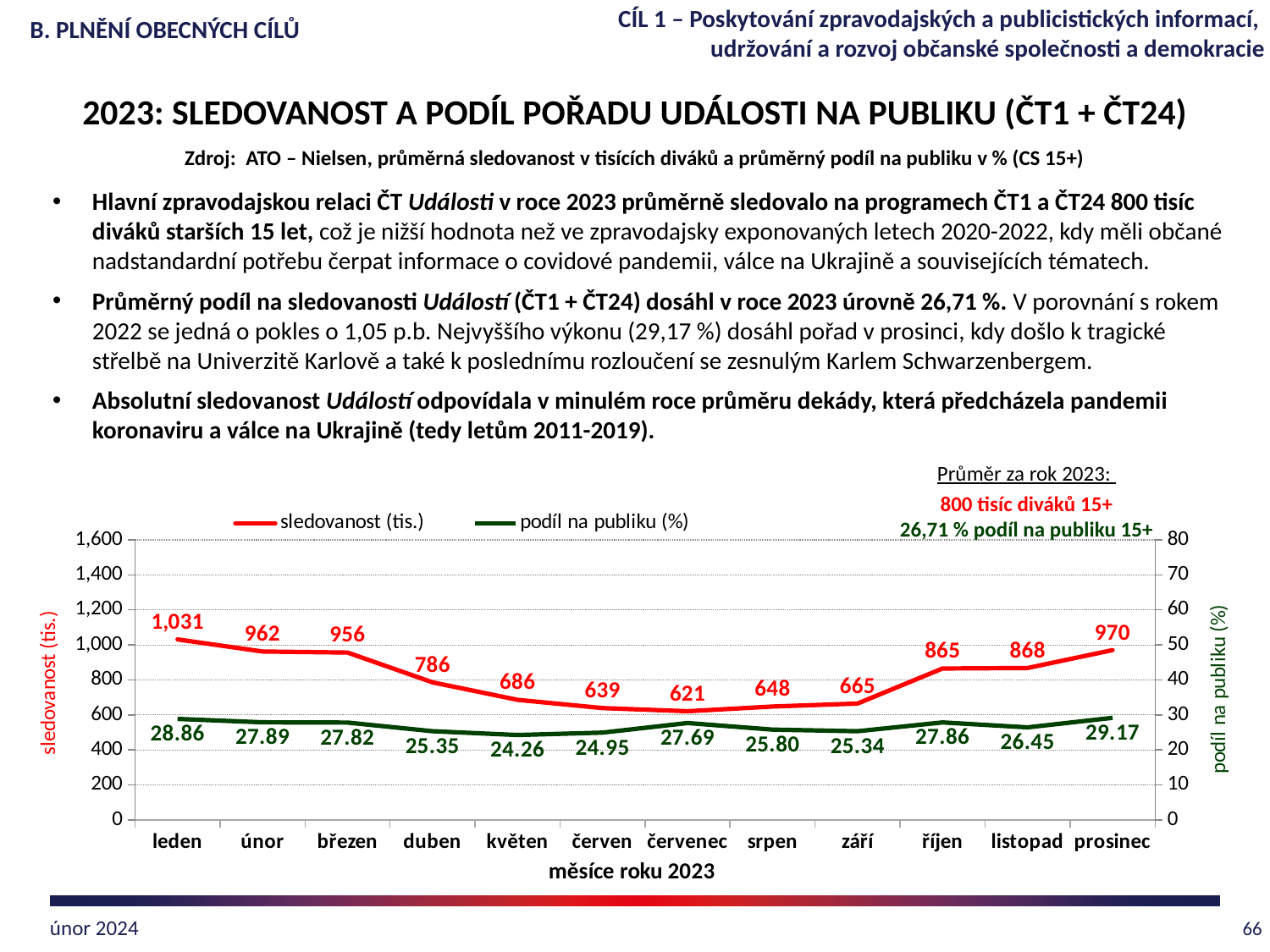
What is the value of sledovanost (tis.) for červenec? 621 What type of chart is shown on the slide? line chart How many series does the chart legend list? 2 How many months are plotted along the x axis of the chart? 12 Which month has the lowest value of podíl na publiku (%)? květen What is the value of podíl na publiku (%) for prosinec? 29.17 Which month has the lowest value of sledovanost (tis.)? červenec Which is larger, the sledovanost (tis.) value for říjen or for listopad? listopad Which month has the highest value of podíl na publiku (%)? prosinec What is the value of sledovanost (tis.) for leden? 1,031 What is the difference between the sledovanost (tis.) values for leden and prosinec? 61 What is the label of the x axis of the chart? měsíce roku 2023